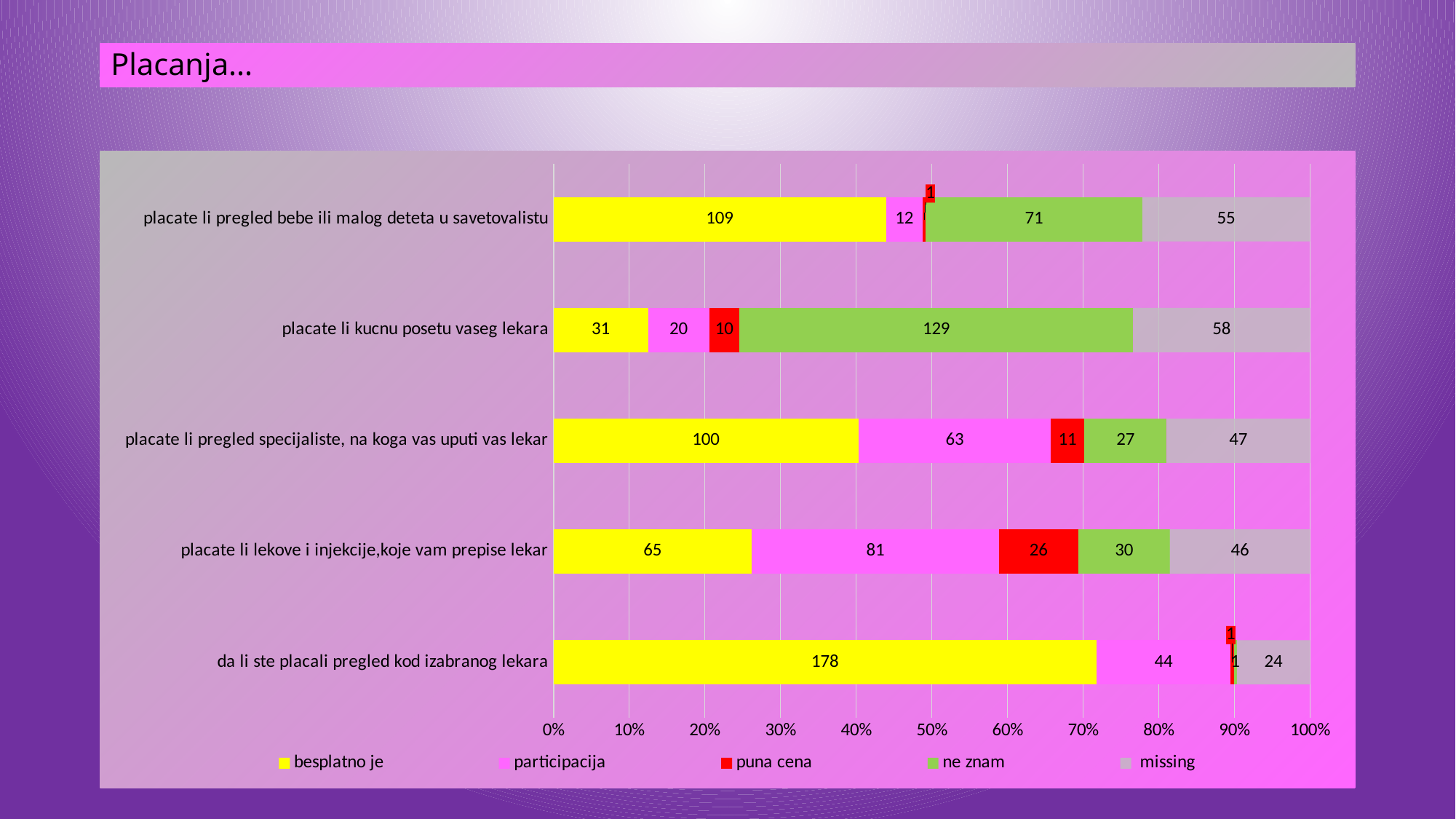
Which is larger: the 'ne znam' value for 'placate li pregled bebe ili malog deteta u savetovalistu' or for 'placate li lekove i injekcije,koje vam prepise lekar'? placate li pregled bebe ili malog deteta u savetovalistu What is the value of 'besplatno je' for 'da li ste placali pregled kod izabranog lekara'? 178 How many series does the legend list? 5 What is the difference between the 'participacija' values for 'placate li lekove i injekcije,koje vam prepise lekar' and 'placate li pregled specijaliste, na koga vas uputi vas lekar'? 18 Which category has the lowest 'besplatno je' value? placate li kucnu posetu vaseg lekara Which category has the highest 'besplatno je' value? da li ste placali pregled kod izabranog lekara What is the value of 'ne znam' for 'placate li kucnu posetu vaseg lekara'? 129 What is the value of 'missing' for 'placate li pregled specijaliste, na koga vas uputi vas lekar'? 47 How many categories are shown on the chart? 5 What is the value of 'puna cena' for 'placate li lekove i injekcije,koje vam prepise lekar'? 26 What kind of chart is shown on the slide? stacked bar chart What is the total of all segments in the bar for 'placate li kucnu posetu vaseg lekara'? 248